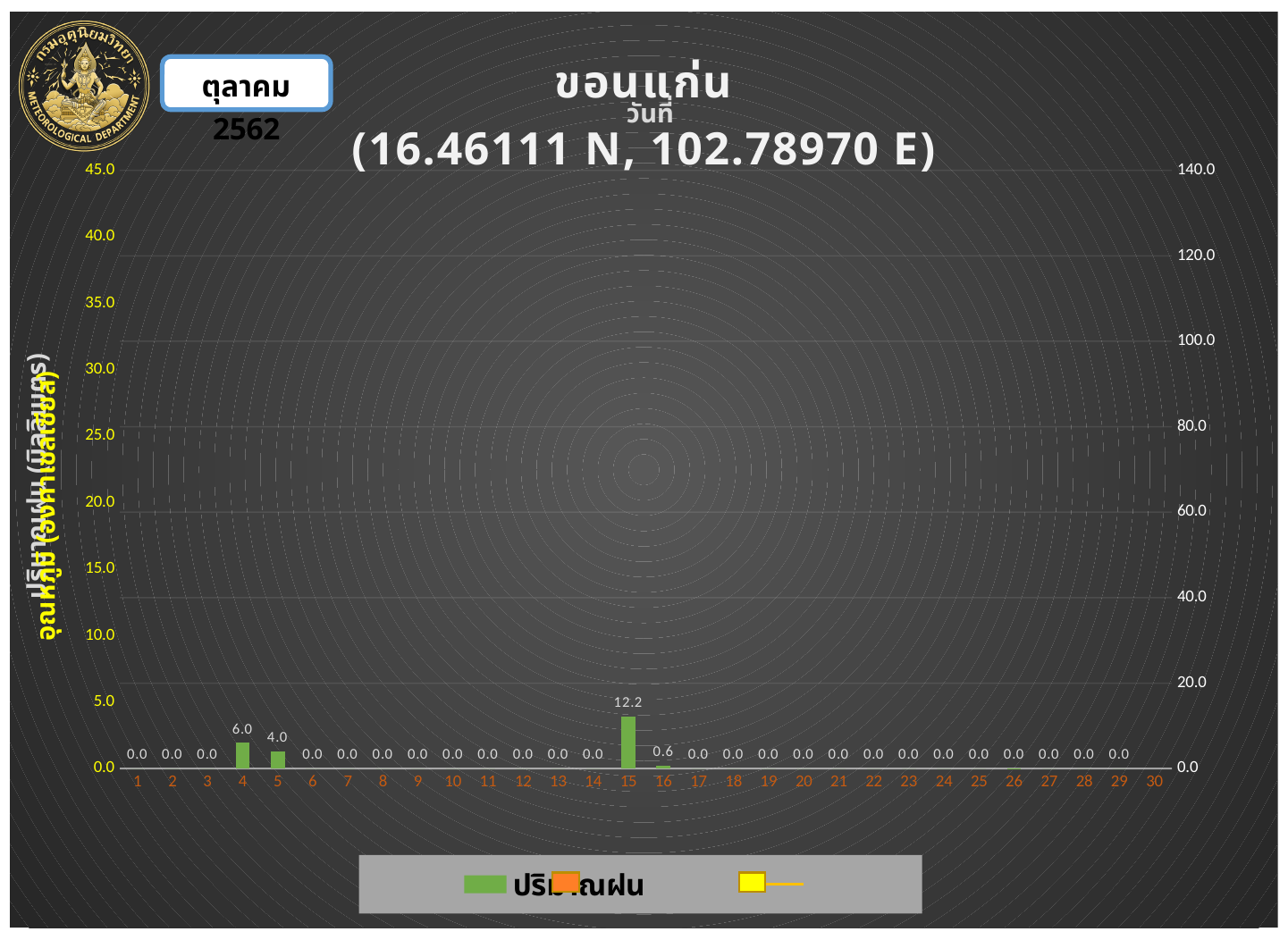
What is the difference between the rainfall values for day 15 and day 4? 6.2 What is the difference between the rainfall values for day 4 and day 5? 2.0 Which day has the larger rainfall value, day 4 or day 5? day 4 What kind of chart is shown on the slide? bar chart What is the rainfall value shown for day 15? 12.2 What is the rainfall value shown for day 5? 4.0 What is the rainfall value shown for day 16? 0.6 What is the rainfall value shown for day 10? 0.0 Which day has the highest rainfall value? 15 How many days are shown on the x axis? 30 What is the rainfall value shown for day 4? 6.0